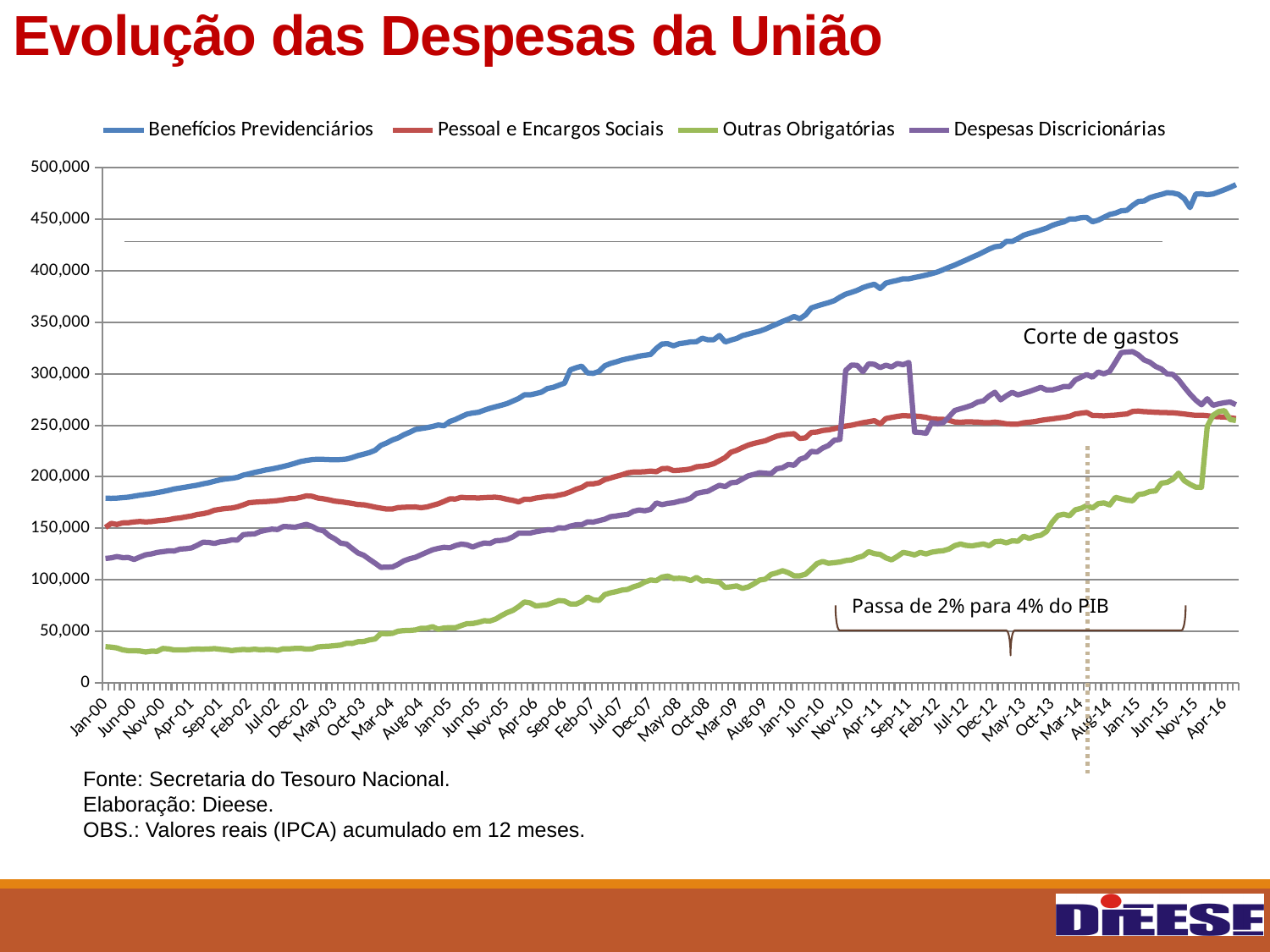
Does the Benefícios Previdenciários series generally rise or fall from Jan-00 to Apr-16? rise Is the value for Despesas Discricionárias at Jan-00 greater or less than 100,000? greater Is the value for Pessoal e Encargos Sociais at Apr-16 greater or less than 300,000? less Which series has the highest value at the end of the period (Apr-16)? Benefícios Previdenciários How many series does the legend list? 4 Is the value for Outras Obrigatórias at Jan-00 greater or less than 50,000? less What is the title of the chart on the slide? Evolução das Despesas da União Does the Despesas Discricionárias series rise or fall between Jan-15 and Apr-16? fall What kind of chart is shown on the slide? line chart At Jan-00, which is larger: Benefícios Previdenciários or Pessoal e Encargos Sociais? Benefícios Previdenciários Which series has the lowest value at Jan-00? Outras Obrigatórias